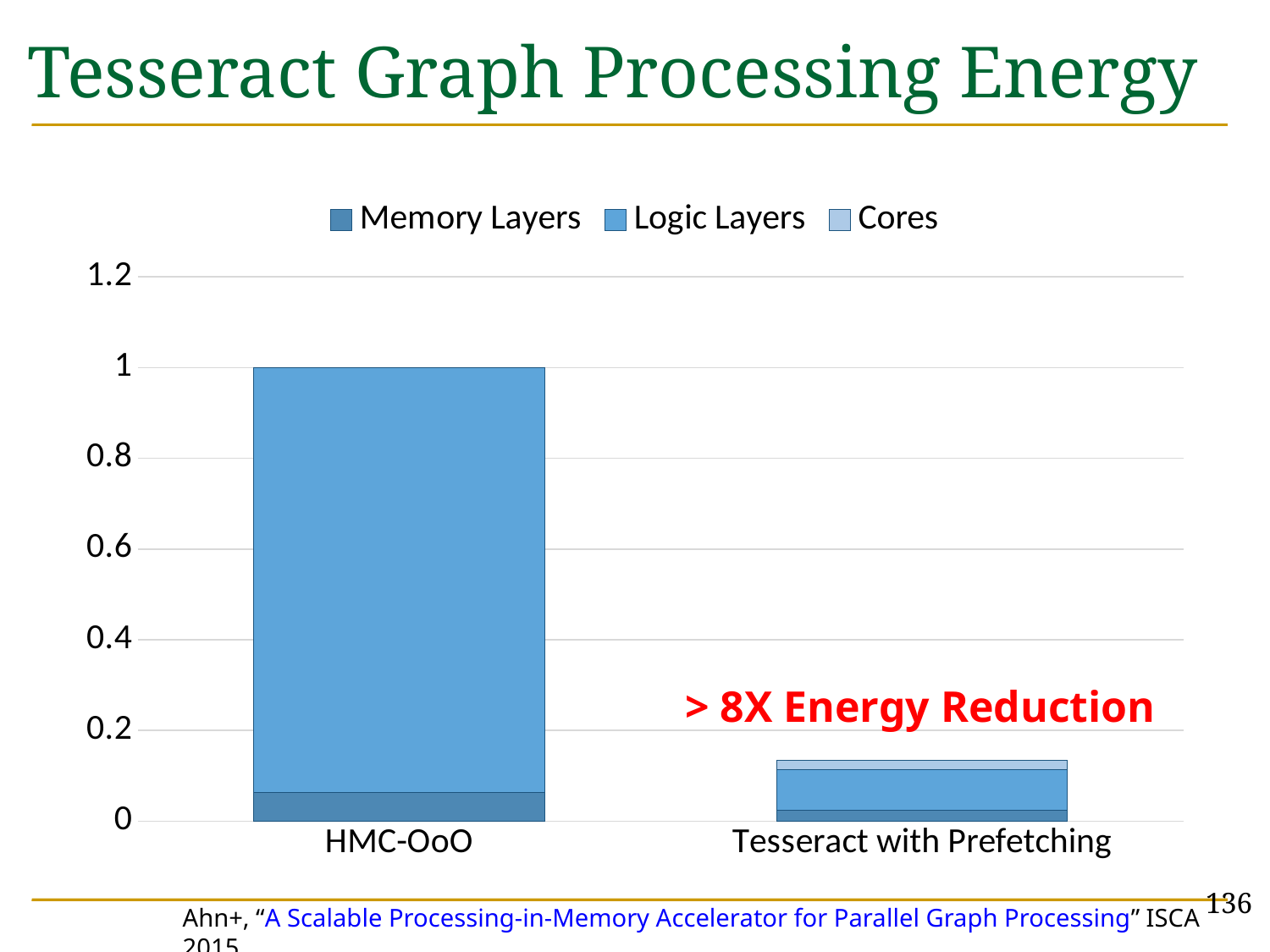
Which category has the highest total stacked bar? HMC-OoO Do the total bar values rise or fall from HMC-OoO to Tesseract with Prefetching? fall Which category has the lowest total stacked bar? Tesseract with Prefetching What kind of chart is shown on the slide? stacked bar chart Is the total value for HMC-OoO greater or less than 0.8? greater What is the total height of the stacked bar for HMC-OoO? 1 How many categories are shown on the x axis of the chart? 2 What are the series listed in the chart legend? Memory Layers, Logic Layers, Cores Which is larger, the total bar for HMC-OoO or the total bar for Tesseract with Prefetching? HMC-OoO What is the title of the slide containing the chart? Tesseract Graph Processing Energy How many series does the chart legend list? 3 Is the total value for Tesseract with Prefetching greater or less than 0.2? less